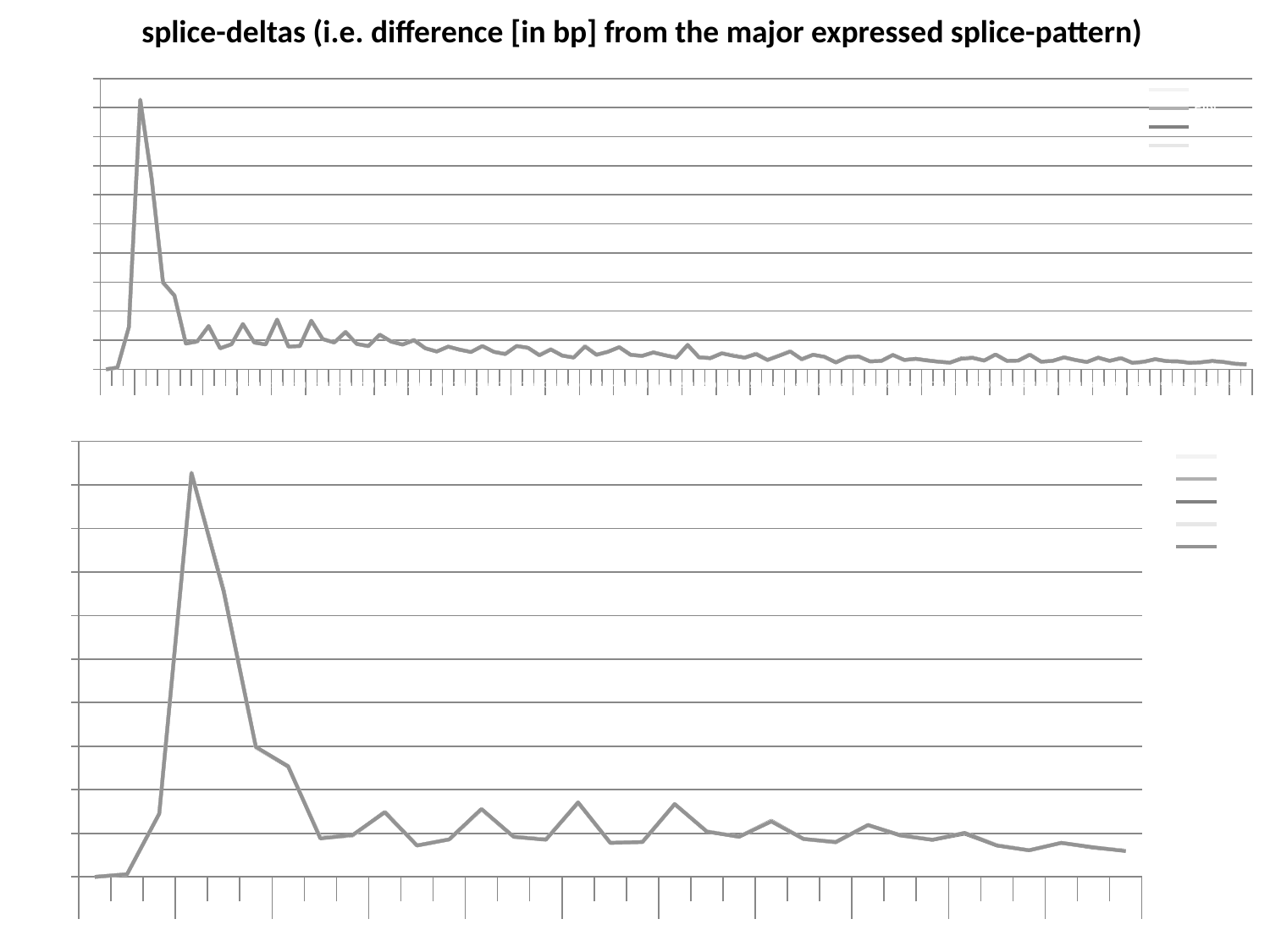
In the bottom chart, is the highest point near the left end or the right end of the x axis? left end In the top chart, after the initial peak, do the values generally rise or fall along the x axis? fall What is the title of the slide's charts? splice-deltas (i.e. difference [in bp] from the major expressed splice-pattern) Which chart has more data points along its x axis, the top chart or the bottom chart? top chart How many charts are shown on the slide? 2 In the top chart, is the highest point near the left end or the right end of the x axis? left end In the bottom chart, after the initial peak, do the values generally rise or fall along the x axis? fall What kind of chart is the top chart? line chart What kind of chart is the bottom chart? line chart